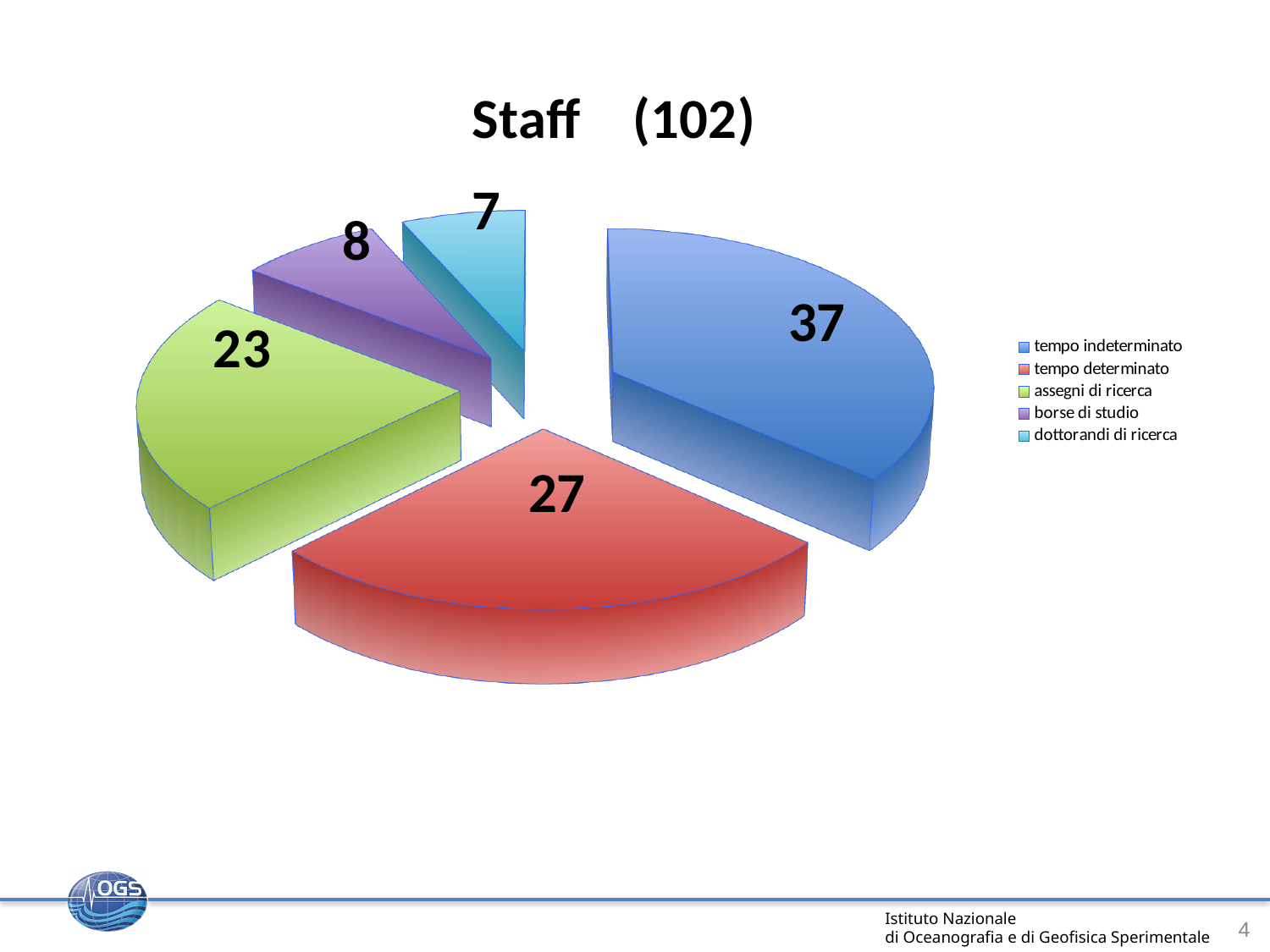
Which is larger, assegni di ricerca or borse di studio? assegni di ricerca What is the value for dottorandi di ricerca? 7 What is the value for borse di studio? 8 What is the difference between tempo indeterminato and tempo determinato? 10 How many categories does the legend list? 5 What is the value for tempo determinato? 27 Which category has the smallest slice? dottorandi di ricerca What type of chart is shown on the slide? pie chart Which category has the largest slice? tempo indeterminato What is the title of the chart? Staff (102) What is the value for tempo indeterminato? 37 What is the value for assegni di ricerca? 23